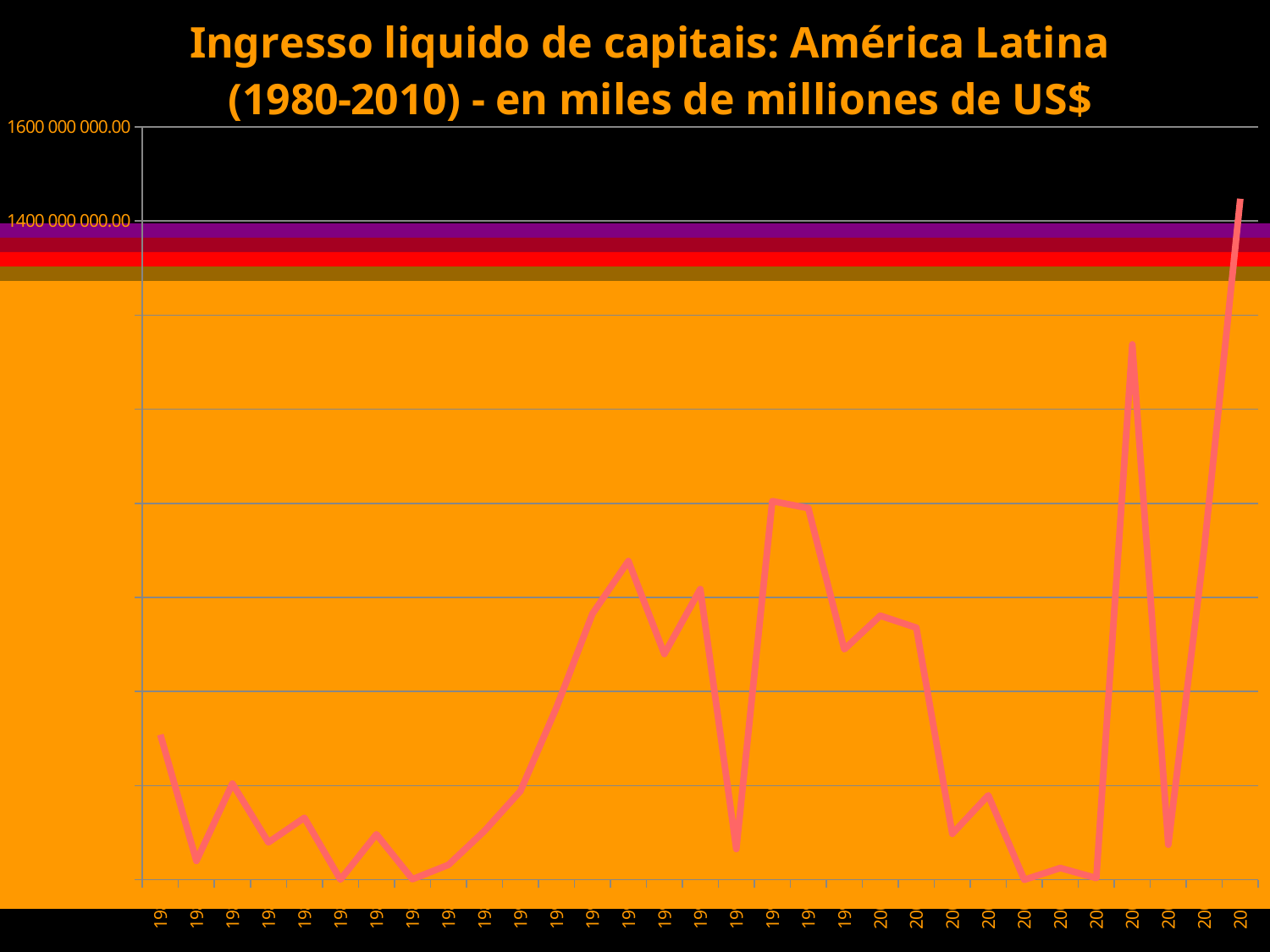
What kind of chart is shown on the slide? line chart What is the title of the chart? Ingresso liquido de capitais: América Latina (1980-2010) - en miles de milliones de US$ Does the line end higher or lower than it starts? higher What is the highest value labelled on the y axis? 1600 000 000.00 Is the value of the second-highest peak of the line (the tall spike near the right side) greater or less than 1400 000 000.00? less How many data points are plotted along the x axis of the chart? 31 How many data series (lines) are plotted on the chart? 1 Is the value of the first (leftmost) point on the line greater or less than 1400 000 000.00? less Where on the x axis does the highest point of the line occur: at the leftmost point, in the middle, or at the rightmost point? at the rightmost point Is the value of the last (rightmost) point on the line greater or less than 1400 000 000.00? greater